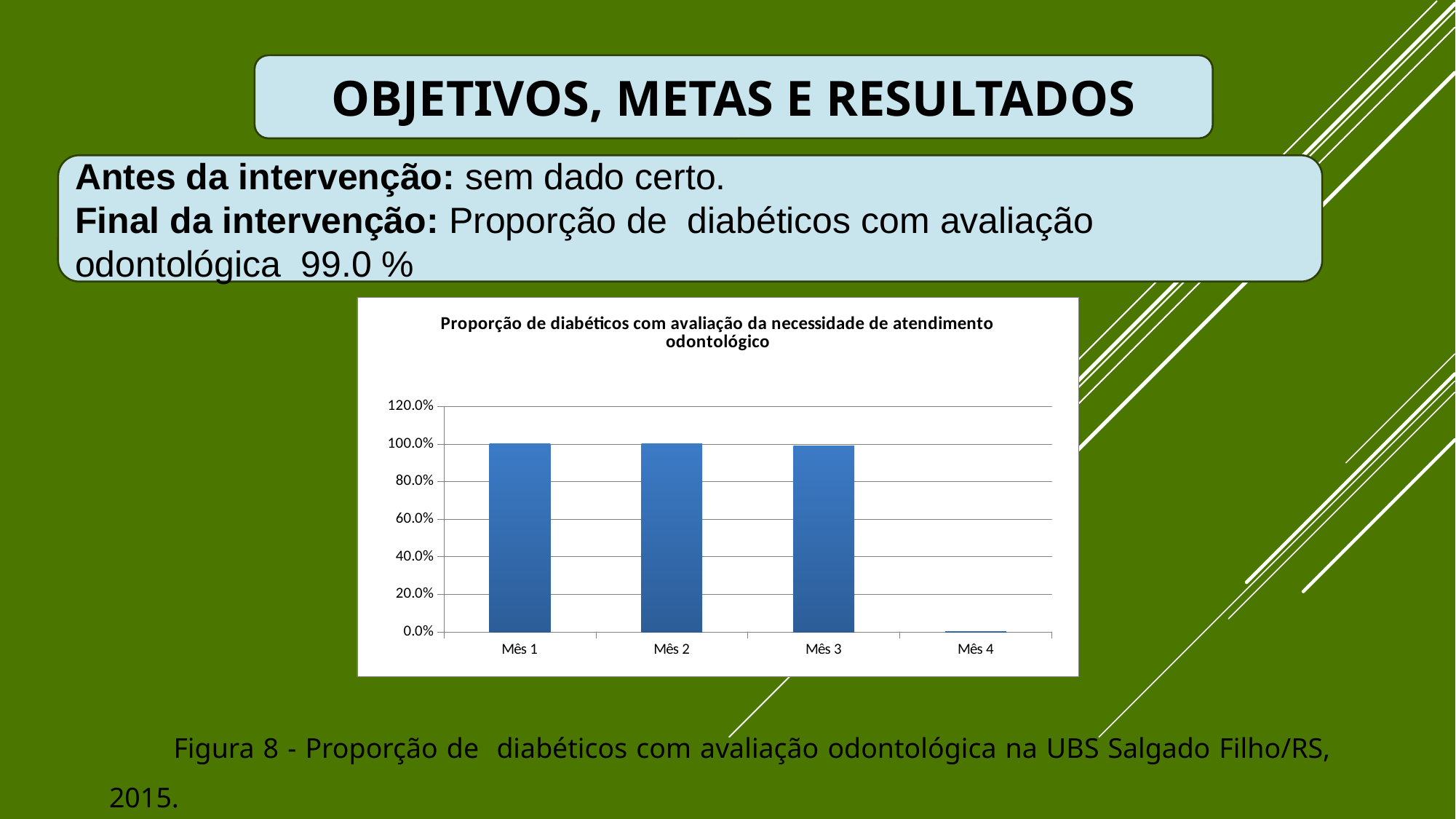
Is the value for Mês 2 greater or less than 60.0%? greater What kind of chart is shown on the slide? bar chart Is the value for Mês 3 greater or less than 80.0%? greater Which is larger, the value for Mês 3 or the value for Mês 4? Mês 3 Which month has the lowest value in the chart? Mês 4 Do the values rise or fall from Mês 1 to Mês 4? fall What is the title of the chart? Proporção de diabéticos com avaliação da necessidade de atendimento odontológico What colour are the bars in the chart? blue Which is larger, the value for Mês 1 or the value for Mês 4? Mês 1 What is the value for Mês 1 in the chart? 100.0% Is the value for Mês 4 greater or less than 20.0%? less How many categories (months) are shown on the x axis of the chart? 4